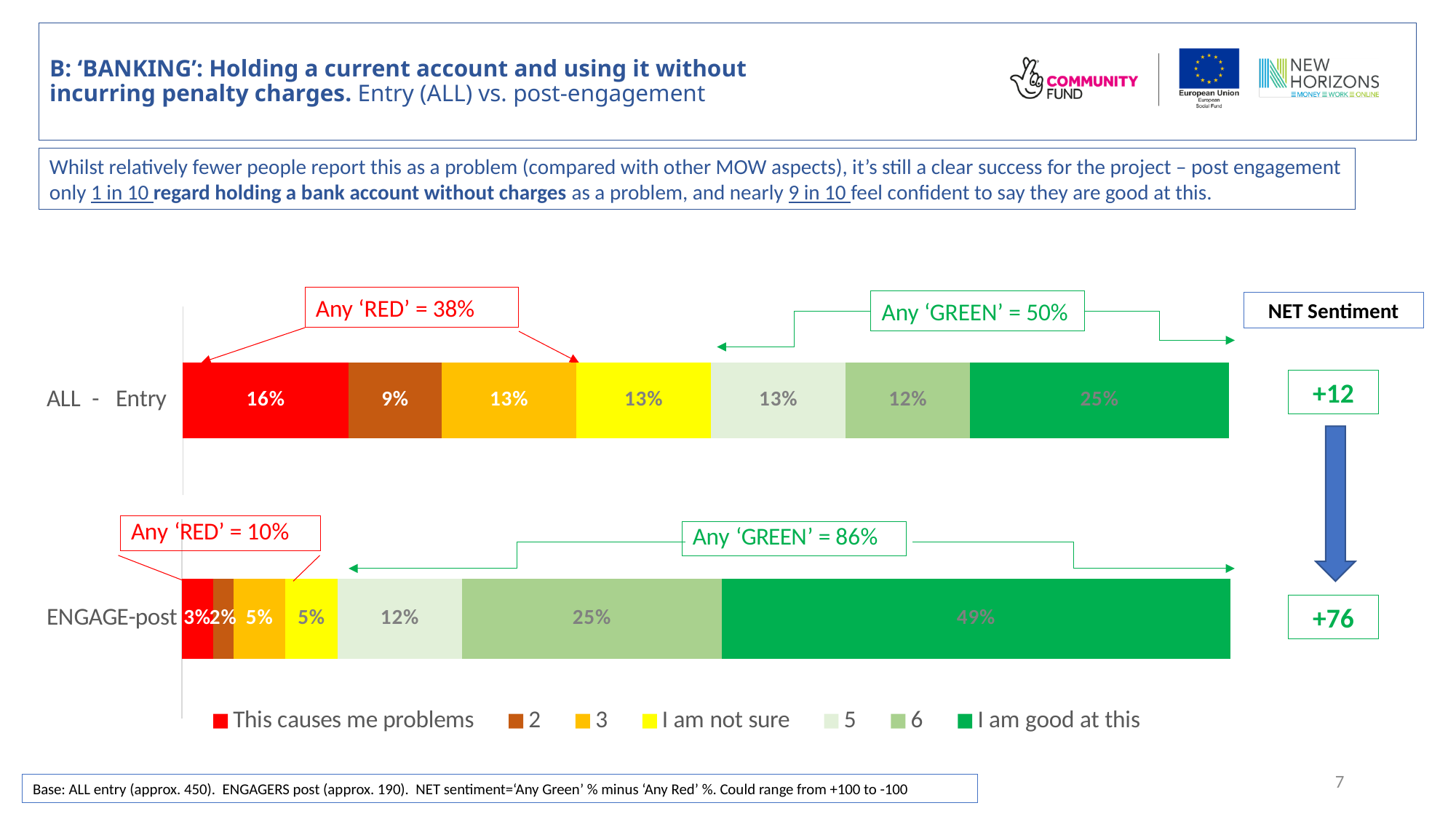
What kind of chart is shown on the slide? Stacked bar chart What percentage of the ENGAGE-post bar is 'I am not sure'? 5% How many series does the legend list? 7 What percentage of the ENGAGE-post bar is 'I am good at this'? 49% Which segment is the smallest in the ENGAGE-post bar? 2 Which segment is the largest in the ENGAGE-post bar? I am good at this What percentage of the ALL - Entry bar is 'This causes me problems'? 16% What is the NET Sentiment value shown for ENGAGE-post? +76 What is the difference between the 'I am good at this' share for ENGAGE-post and for ALL - Entry? 24% Which is larger: the 'This causes me problems' share for ALL - Entry or for ENGAGE-post? ALL - Entry What percentage of the ALL - Entry bar is 'I am good at this'? 25% How many bars (categories) are plotted in the chart? 2